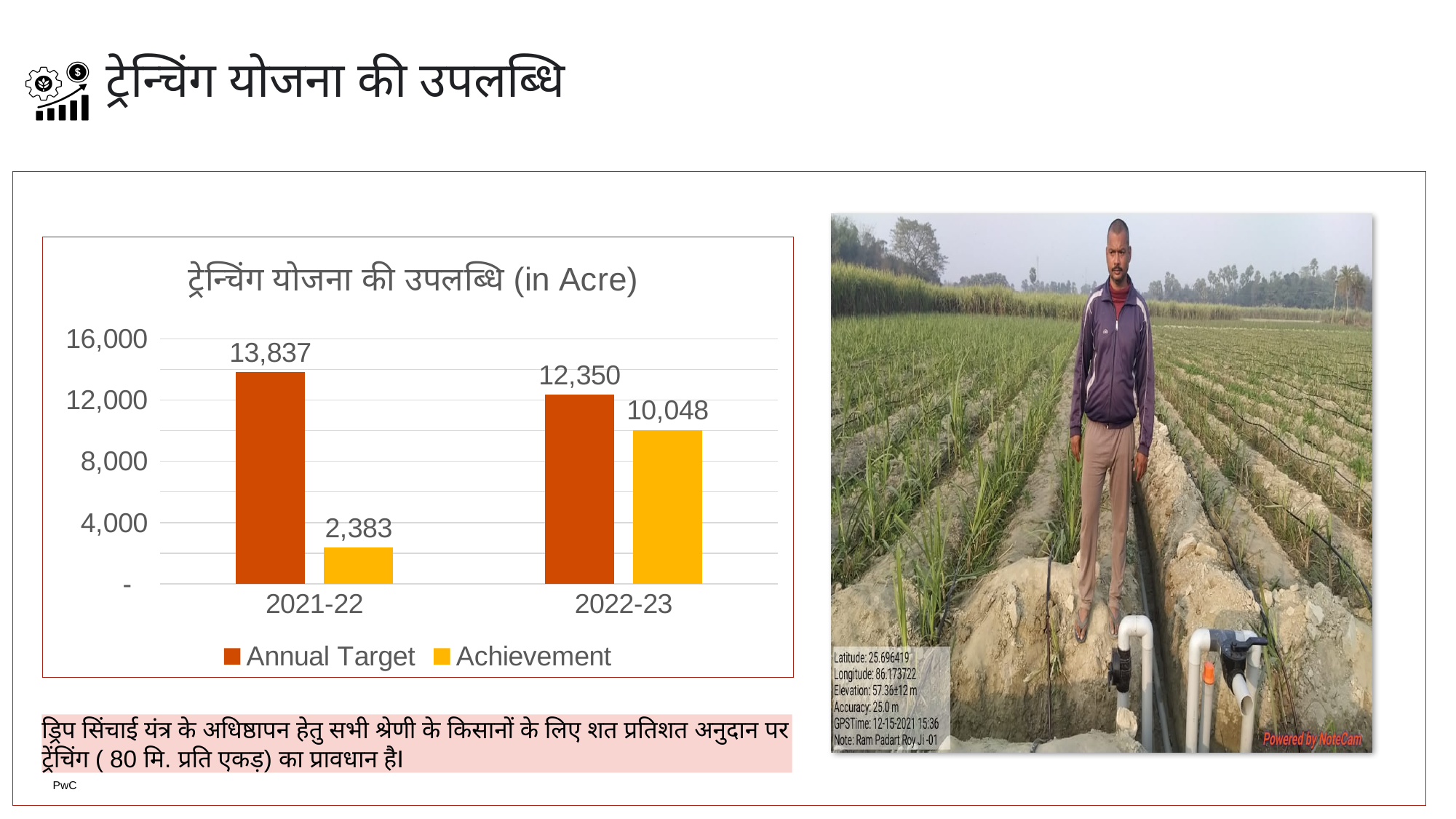
How many series does the legend list? 2 Which year has the lower Annual Target value? 2022-23 Which year has the higher Achievement value? 2022-23 What is the difference between the Annual Target and Achievement for 2021-22? 11,454 What is the Annual Target value for 2021-22? 13,837 What is the Annual Target value for 2022-23? 12,350 What is the difference between the Annual Target and Achievement for 2022-23? 2,302 Is the Annual Target for 2021-22 larger or smaller than the Annual Target for 2022-23? larger What is the Achievement value for 2021-22? 2,383 What colour are the Achievement bars? yellow What kind of chart is shown on the slide? bar chart What is the Achievement value for 2022-23? 10,048